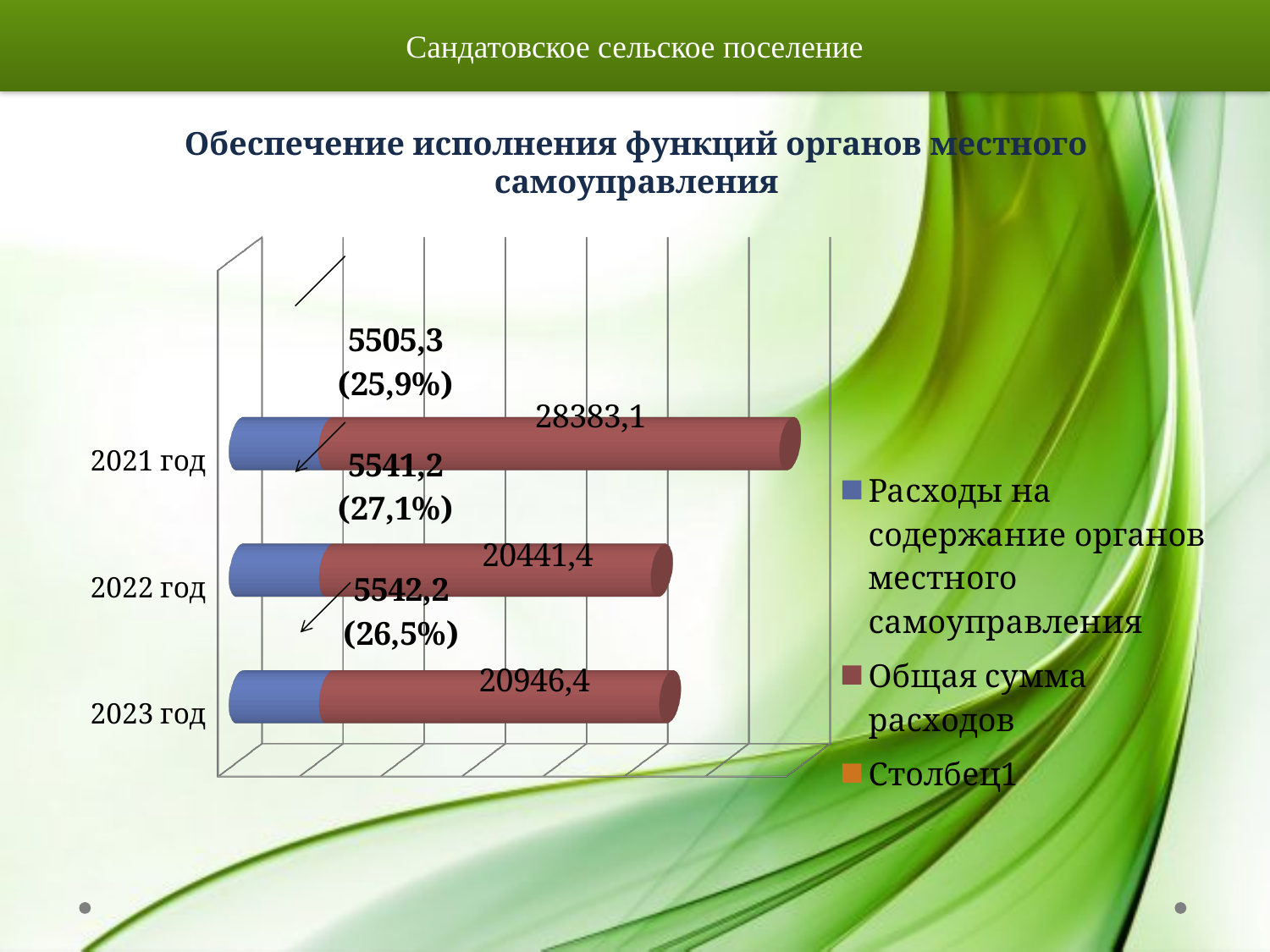
Which year has the lowest Общая сумма расходов? 2022 год How many series does the chart legend list? 3 What kind of chart is shown on the slide? bar chart What is the value of Общая сумма расходов for 2023 год? 20946,4 What colour are the bars for the series Общая сумма расходов? red Which year has the larger Общая сумма расходов, 2022 год or 2023 год? 2023 год What is the value of Общая сумма расходов for 2021 год? 28383,1 What is the difference between Общая сумма расходов in 2021 год and 2022 год? 7941,7 What is the third entry listed in the chart legend? Столбец1 How many years (categories) are shown on the chart? 3 What is the value of Общая сумма расходов for 2022 год? 20441,4 Which year has the highest Общая сумма расходов? 2021 год